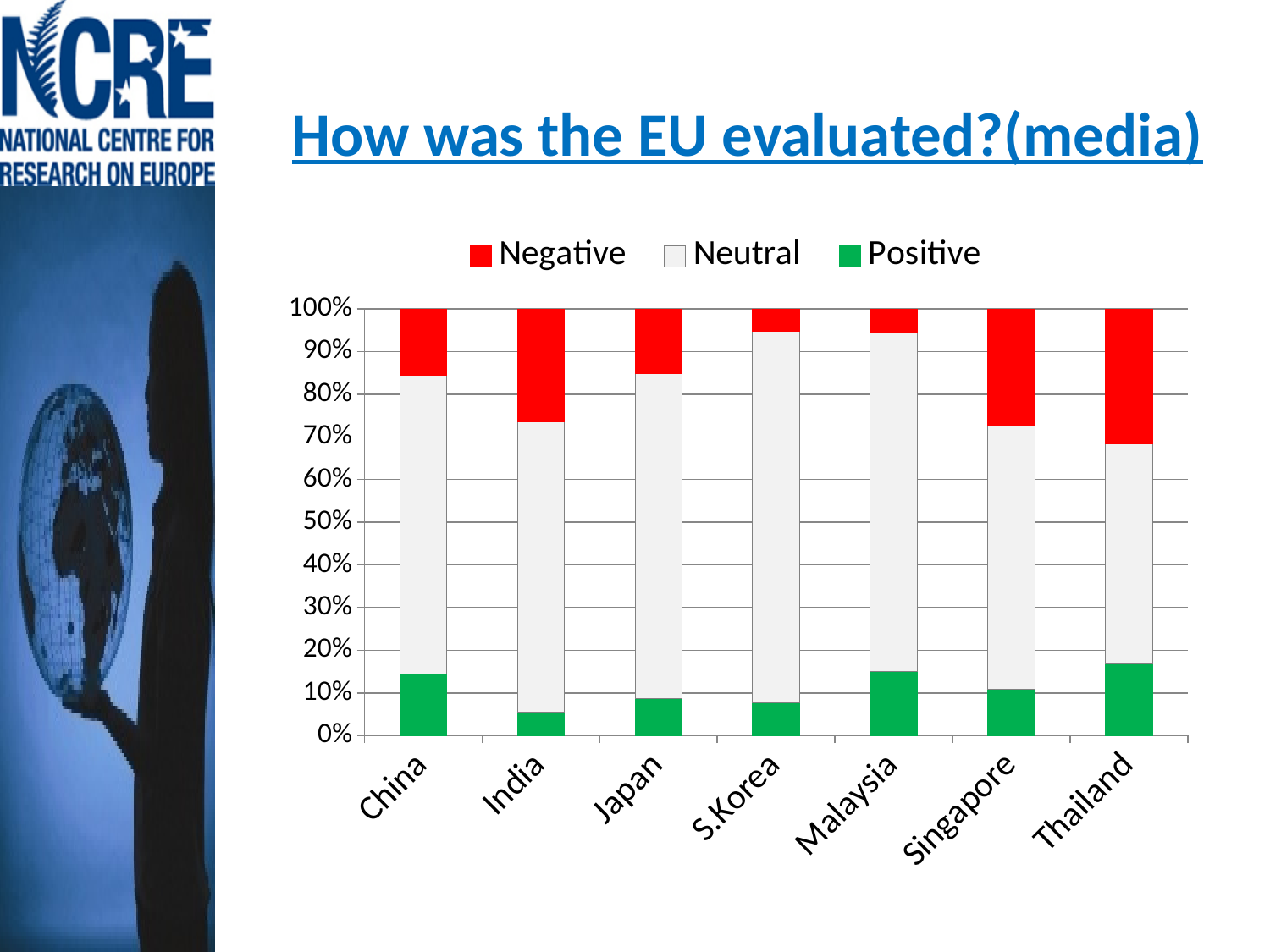
How many countries are shown on the x axis of the chart? 7 Is the Negative share for S.Korea greater or less than 10%? less Which colour represents the Negative series in the chart? red What kind of chart is shown on the slide? stacked bar chart Which is larger, the Negative share for India or the Negative share for China? India Is the Negative share for Singapore greater or less than 20%? greater Which country has the largest Negative share? Thailand How many series does the chart's legend list? 3 What is the title of the chart slide? How was the EU evaluated?(media) Is the Positive share for India greater or less than 10%? less Which is larger, the Neutral share for S.Korea or the Neutral share for Thailand? S.Korea